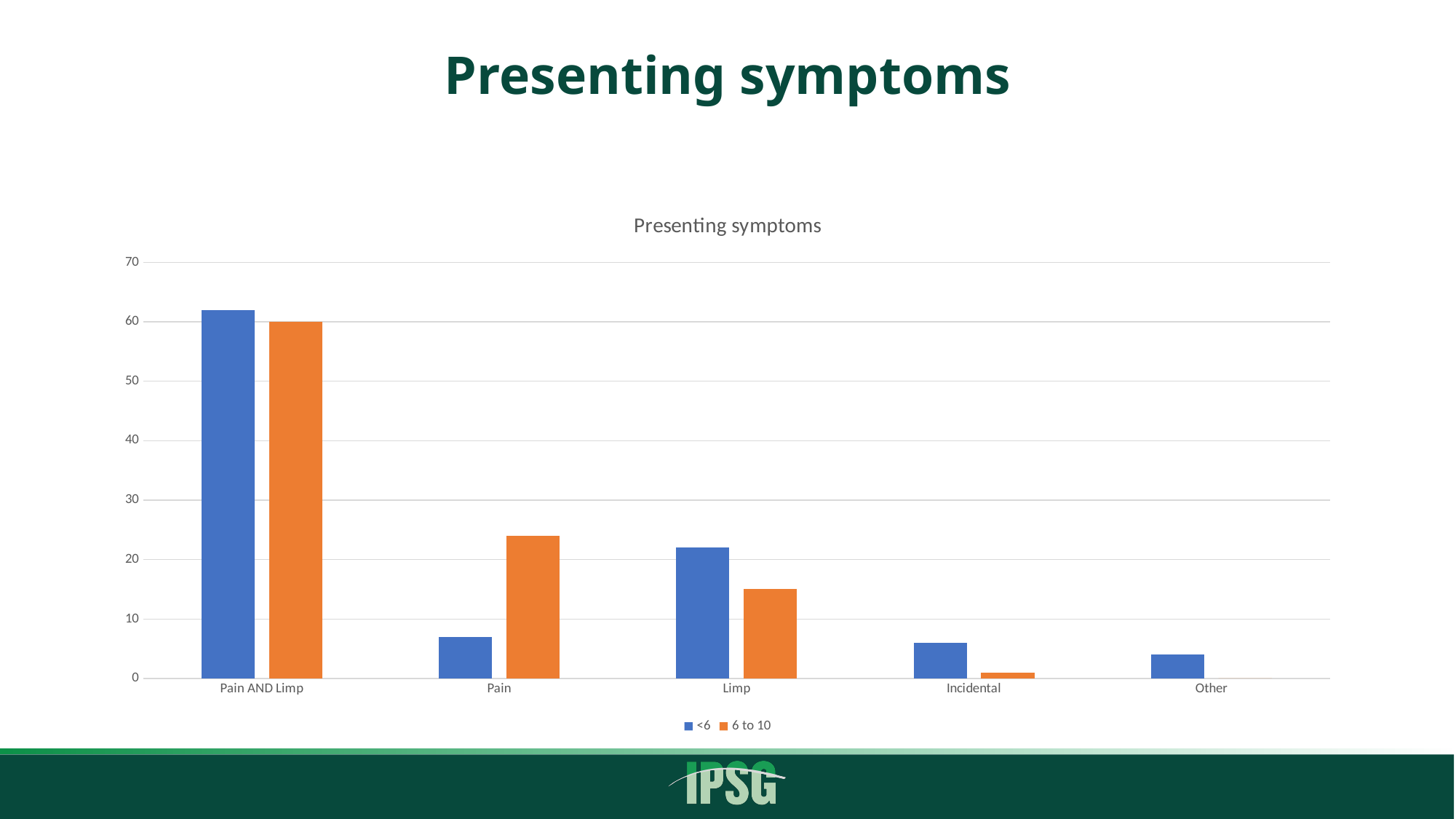
Which category has the highest value for the <6 series? Pain AND Limp How many categories are shown on the x axis? 5 Is the value for Incidental in the <6 series greater or less than 10? less How many series does the legend list? 2 Is the value for Limp in the <6 series greater or less than 20? greater Is the value for Pain AND Limp in the <6 series greater or less than 60? greater What kind of chart is shown on the slide? bar chart Which category has the lowest value for the 6 to 10 series among those with a visible bar? Incidental For the Pain category, which series has the larger value, <6 or 6 to 10? 6 to 10 For the Limp category, which series has the larger value, <6 or 6 to 10? <6 Which colour represents the 6 to 10 series? orange